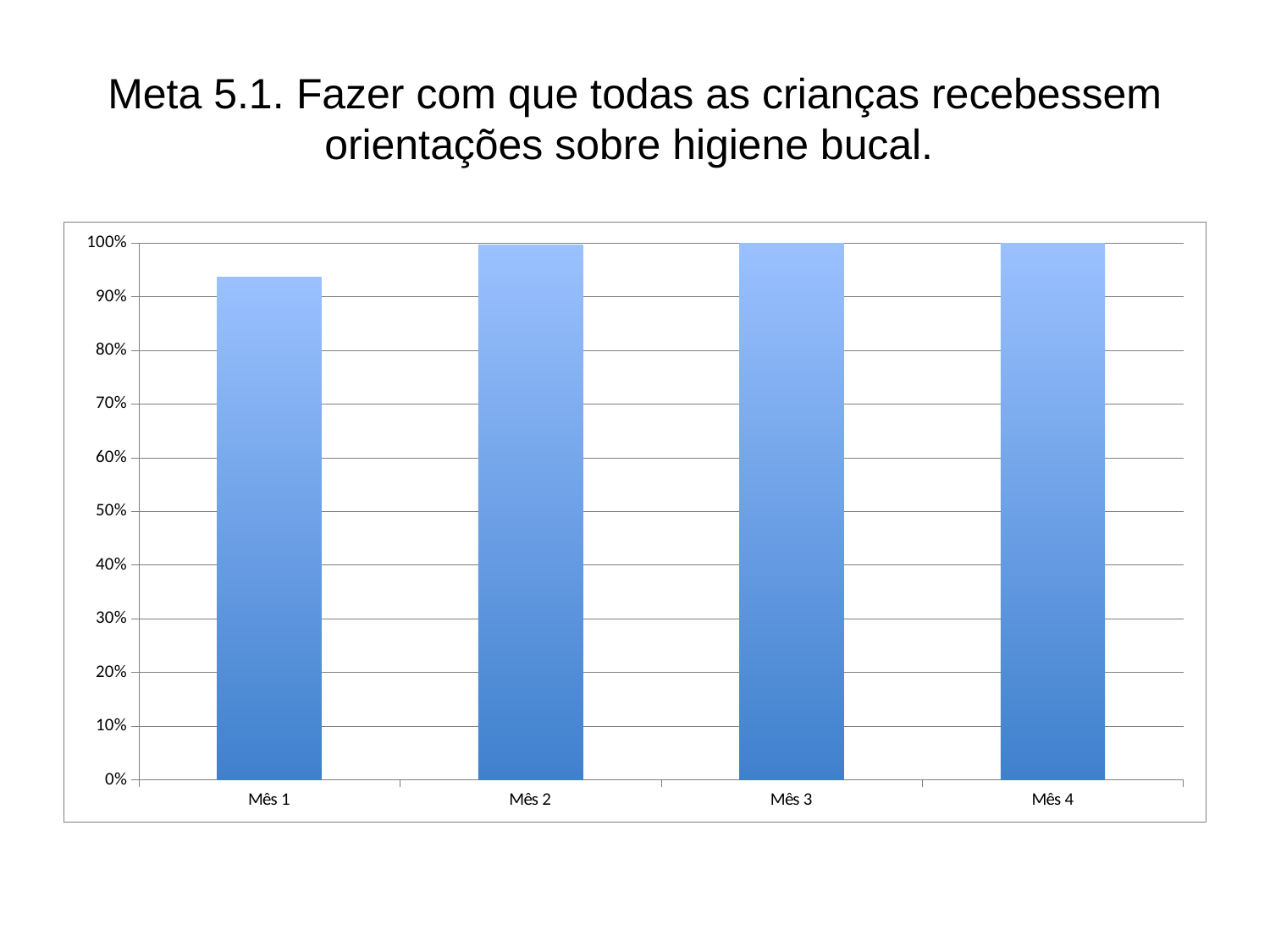
Which is larger, the value for Mês 1 or the value for Mês 4? Mês 4 Do the values generally rise or fall from Mês 1 to Mês 4? rise What is the title of the slide containing the chart? Meta 5.1. Fazer com que todas as crianças recebessem orientações sobre higiene bucal. Which is larger, the value for Mês 1 or the value for Mês 3? Mês 3 Is the value for Mês 1 greater or less than 100%? less How many months (categories) are shown on the x axis of the chart? 4 What kind of chart is shown on the slide? bar chart What is the highest value shown on the y axis of the chart? 100% Is the value for Mês 1 greater or less than 90%? greater Is the value for Mês 3 greater or less than 80%? greater Which month has the lowest value in the chart? Mês 1